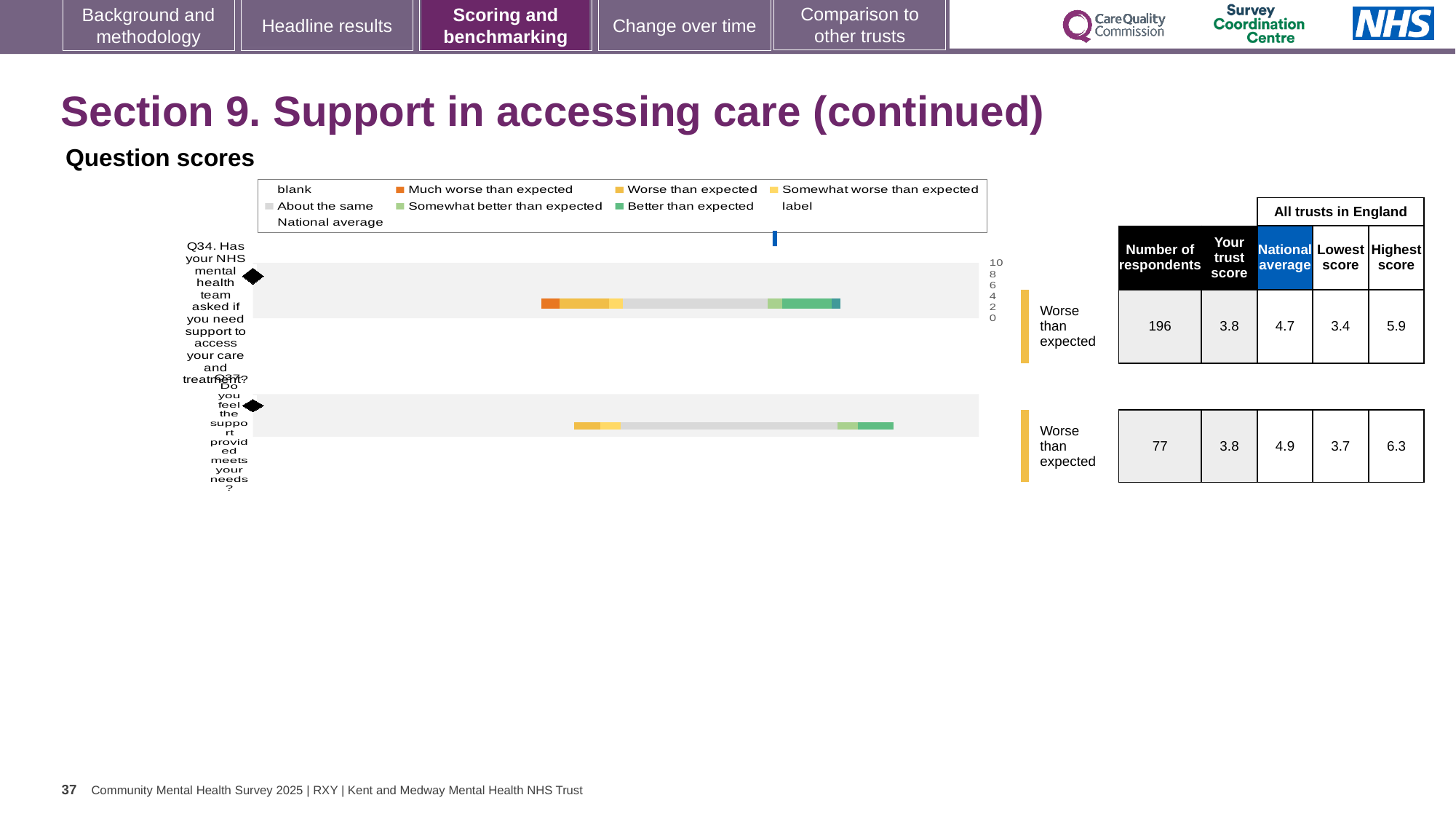
How many questions are plotted in the chart? 2 What is the highest score across all trusts in England for Q37? 6.3 What is the trust score for Q34 in the table beside the chart? 3.8 What is the benchmark rating shown for Q34? Worse than expected Which colour in the legend represents 'Much worse than expected'? orange How many respondents answered Q34? 196 What is the national average for Q37 in the table beside the chart? 4.9 Which question has the higher national average, Q34 or Q37? Q37 How many more respondents answered Q34 than Q37? 119 What is the difference between the national average and the trust score for Q34? 0.9 What is the benchmark rating shown for Q37? Worse than expected What kind of chart is shown under 'Question scores'? bar chart